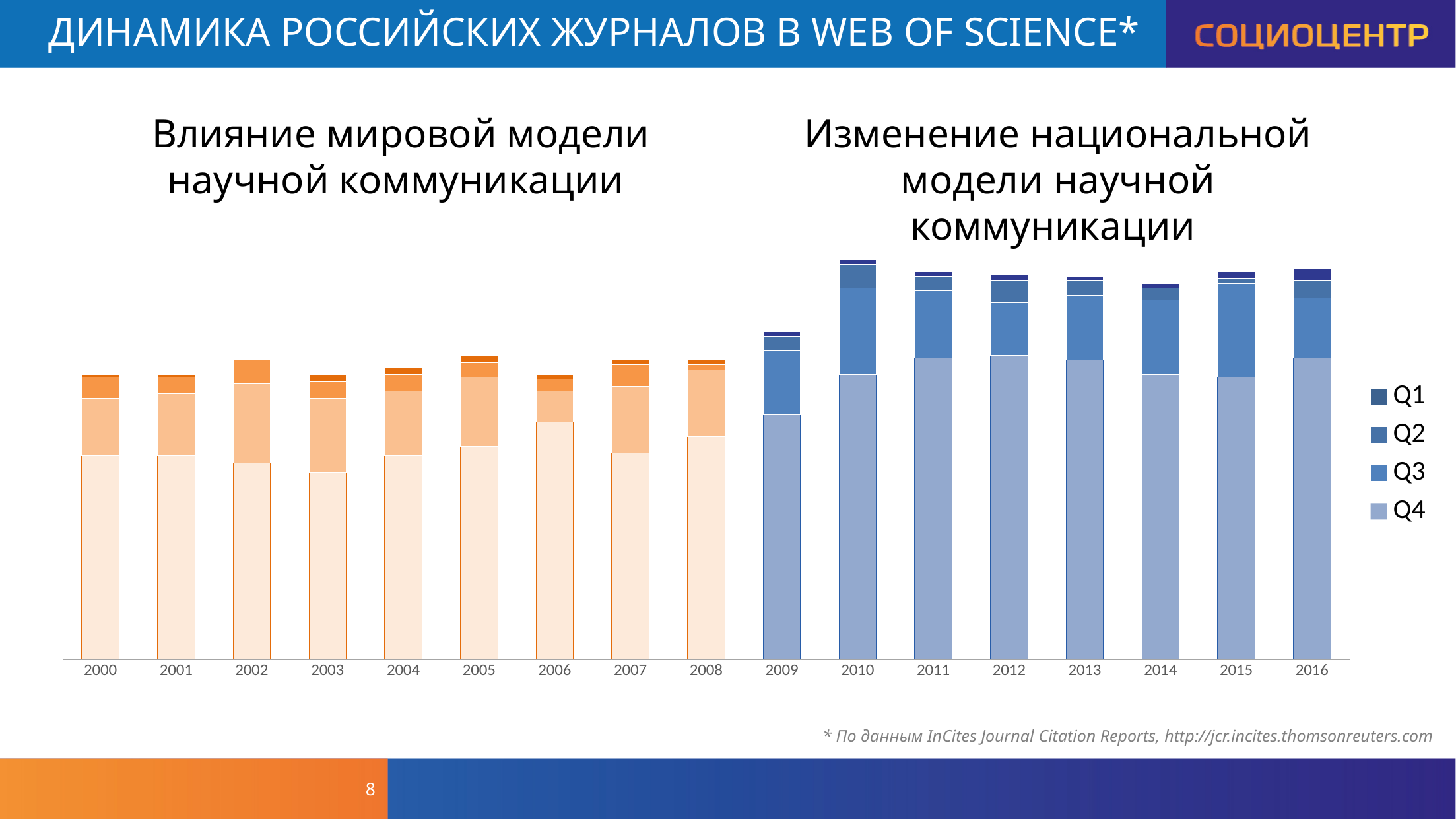
Which is larger, the total bar for 2010 or the total bar for 2009? 2010 Which is larger, the total bar for 2010 or the total bar for 2000? 2010 What are the entries listed in the chart's legend? Q1, Q2, Q3, Q4 Which is larger, the Q4 segment for 2012 or the Q4 segment for 2009? 2012 What kind of chart is shown on the slide? bar chart What is the last year shown on the x axis? 2016 How many years are shown along the x axis of the chart? 17 What is the first year shown on the x axis? 2000 How many series does the chart's legend list? 4 Which years are drawn in orange rather than blue in the chart? 2000 to 2008 Do the total bar heights generally rise or fall from 2000 to 2016? rise